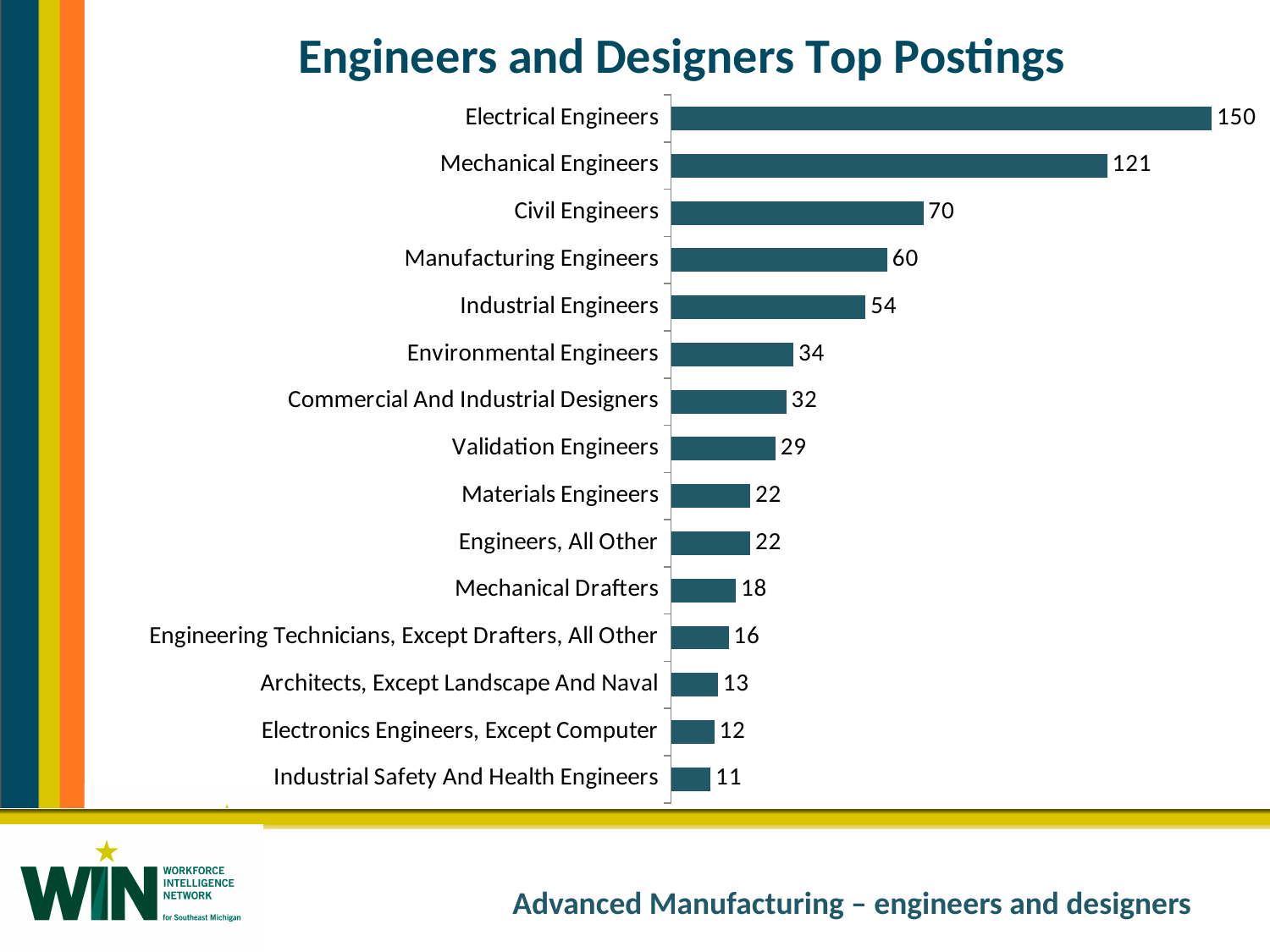
What is the title of the chart? Engineers and Designers Top Postings What is the value for Civil Engineers? 70 How many categories are shown in the chart? 15 What is the value for Electrical Engineers? 150 What is the difference between the values for Manufacturing Engineers and Industrial Engineers? 6 What is the difference between the values for Electrical Engineers and Mechanical Engineers? 29 What is the value for Validation Engineers? 29 Which is larger, the value for Environmental Engineers or the value for Validation Engineers? Environmental Engineers Which category has the lowest value? Industrial Safety And Health Engineers Which category has the highest value? Electrical Engineers What kind of chart is shown on the slide? Bar chart What is the value for Mechanical Drafters? 18